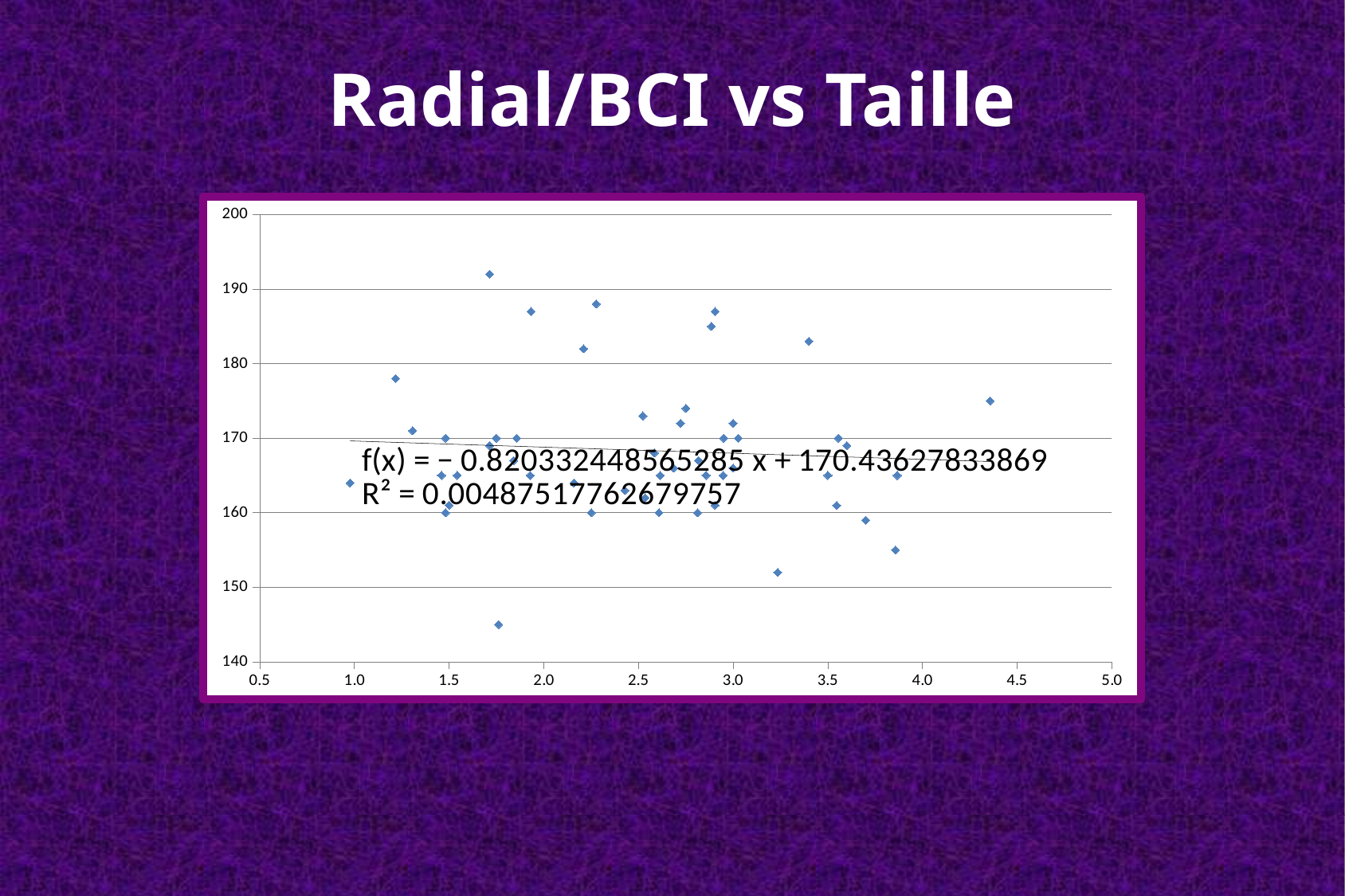
Is the value of the point near x = 3.2 greater or less than 160? less Is the value of the rightmost point (near x = 4.35) greater or less than 170? greater What is the maximum value shown on the y axis? 200 What is the title of the slide's chart? Radial/BCI vs Taille What is the slope of the fitted line f(x) printed on the chart? −0.820332448565285 What is the intercept of the fitted line f(x) printed on the chart? 170.43627833869 Is the lowest point on the chart greater or less than 150? less Does the fitted trend line slope upward or downward as x increases? downward What kind of chart is shown on the slide? Scatter plot What is the R² value printed on the chart? 0.00487517762679757